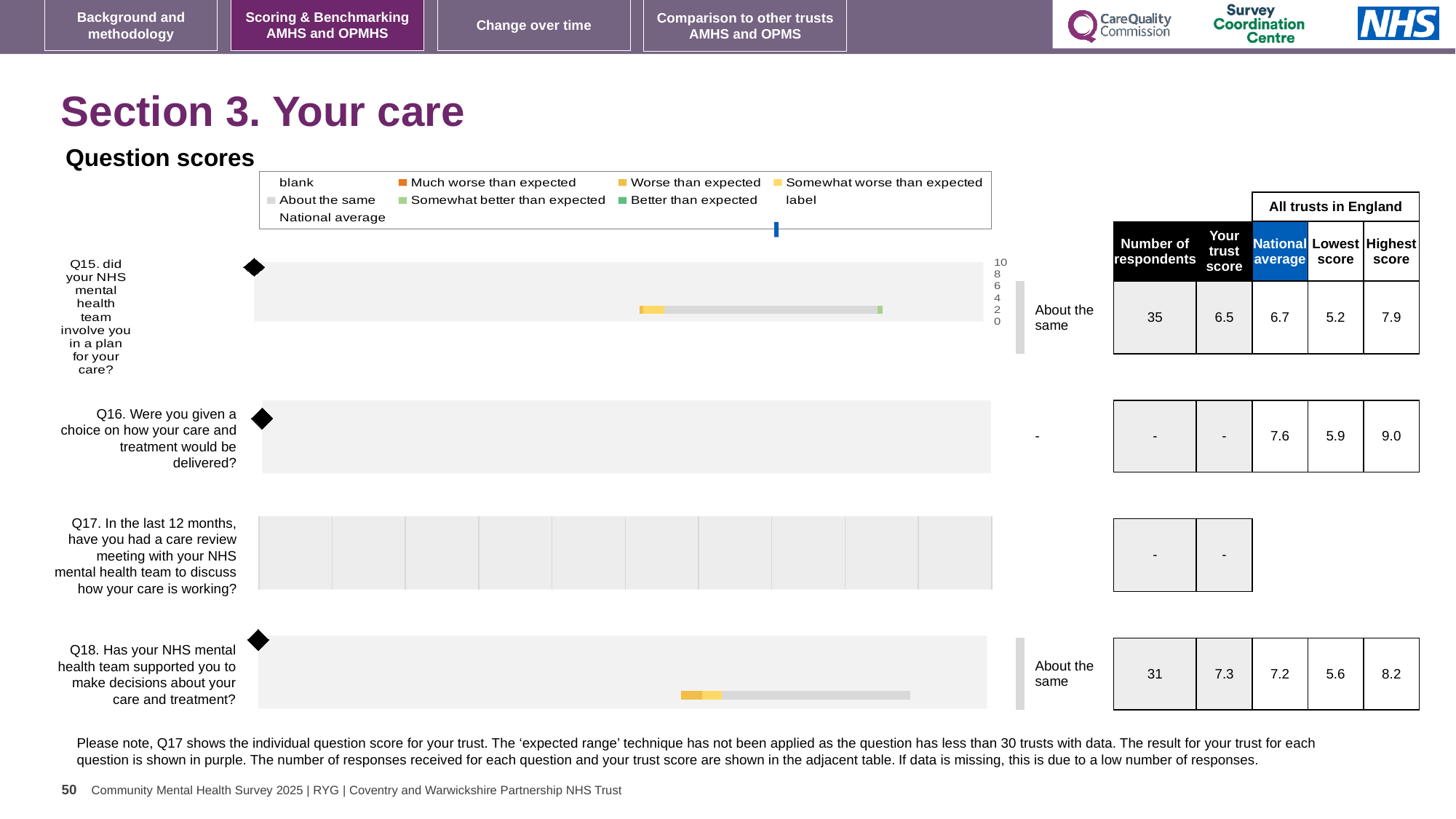
What is the number of respondents shown for Q18? 31 What category label is shown next to the bars for Q15 and Q18? About the same What kind of chart is used to show the question scores on this slide? bar chart What is the number of respondents shown for Q15 in the table next to the chart? 35 What is the national average shown for Q16 (choice on how your care and treatment would be delivered)? 7.6 Which question has the highest 'Highest score' value in the table? Q16 What is the difference between the highest score and the lowest score for Q15? 2.7 Which question has more respondents, Q15 or Q18? Q15 How many questions (Q15 to Q18) are plotted as rows in the chart? 4 What is the highest score across all trusts in England for Q18? 8.2 For Q18, which is larger: the trust score or the national average? trust score What is the trust score shown for Q15 (involve you in a plan for your care)? 6.5